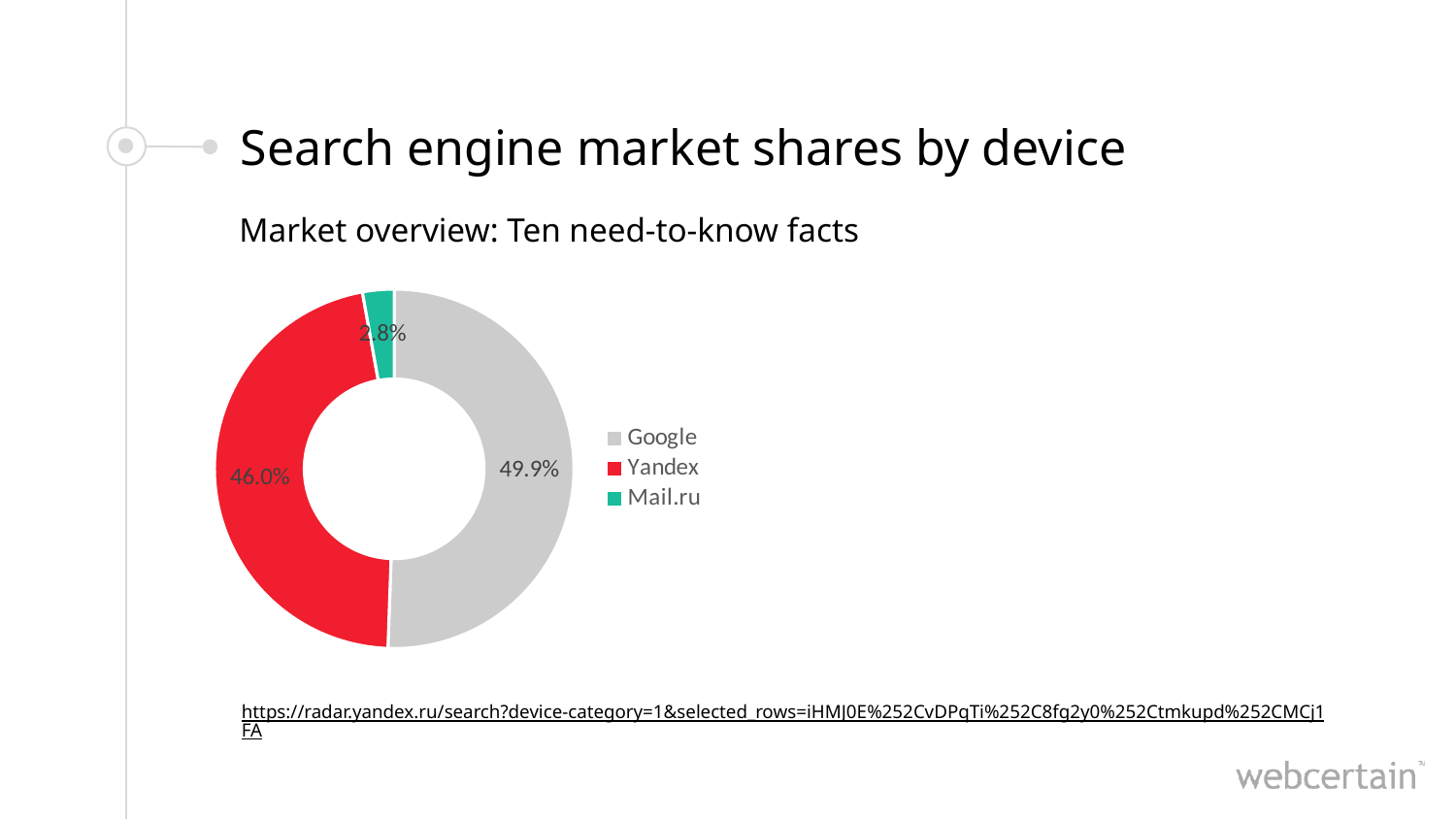
How many search engines are shown in the chart? 3 What kind of chart is shown on the slide? Doughnut (pie) chart What is the difference in percentage points between Google's and Yandex's shares? 3.9 What share of the chart does Yandex have? 46.0% What is the title of the slide containing the chart? Search engine market shares by device What is the difference in percentage points between Yandex's and Mail.ru's shares? 43.2 What share of the chart does Google have? 49.9% What colour represents Yandex in the chart? Red What share of the chart does Mail.ru have? 2.8% Which search engine has the largest share in the chart? Google Which has a larger share, Yandex or Mail.ru? Yandex Which search engine has the smallest share in the chart? Mail.ru